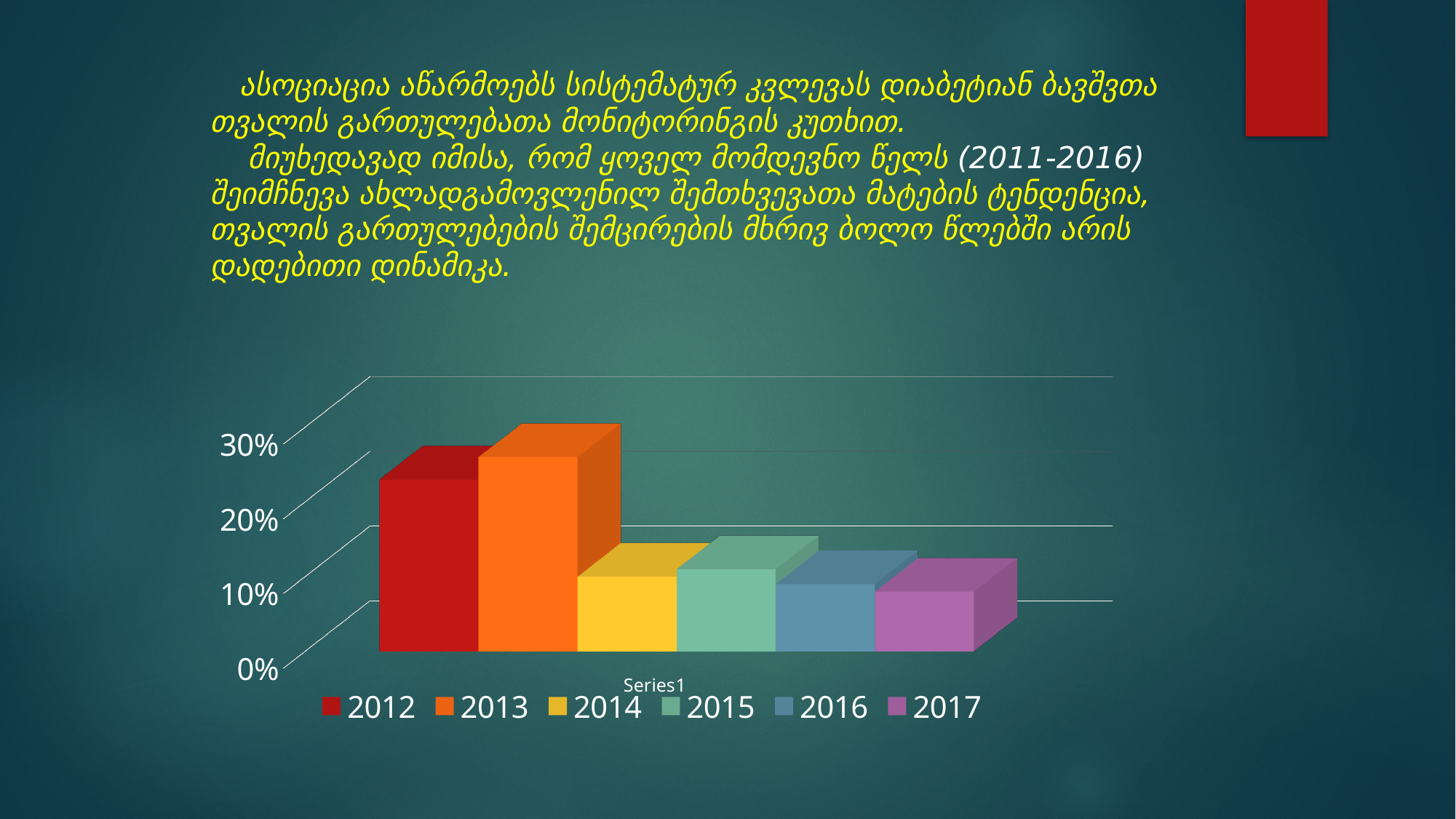
What colour is the bar for 2017 in the legend? purple Which is larger, the value for 2013 or the value for 2016? 2013 Is the value for 2017 greater or less than 20%? less Do the values generally rise or fall from 2013 to 2017? fall Is the value for 2014 greater or less than 20%? less Is the value for 2013 greater or less than 20%? greater How many series does the legend list? 6 Which is larger, the value for 2012 or the value for 2013? 2013 What kind of chart is shown on the slide? bar chart Which year has the highest bar? 2013 Which is larger, the value for 2012 or the value for 2014? 2012